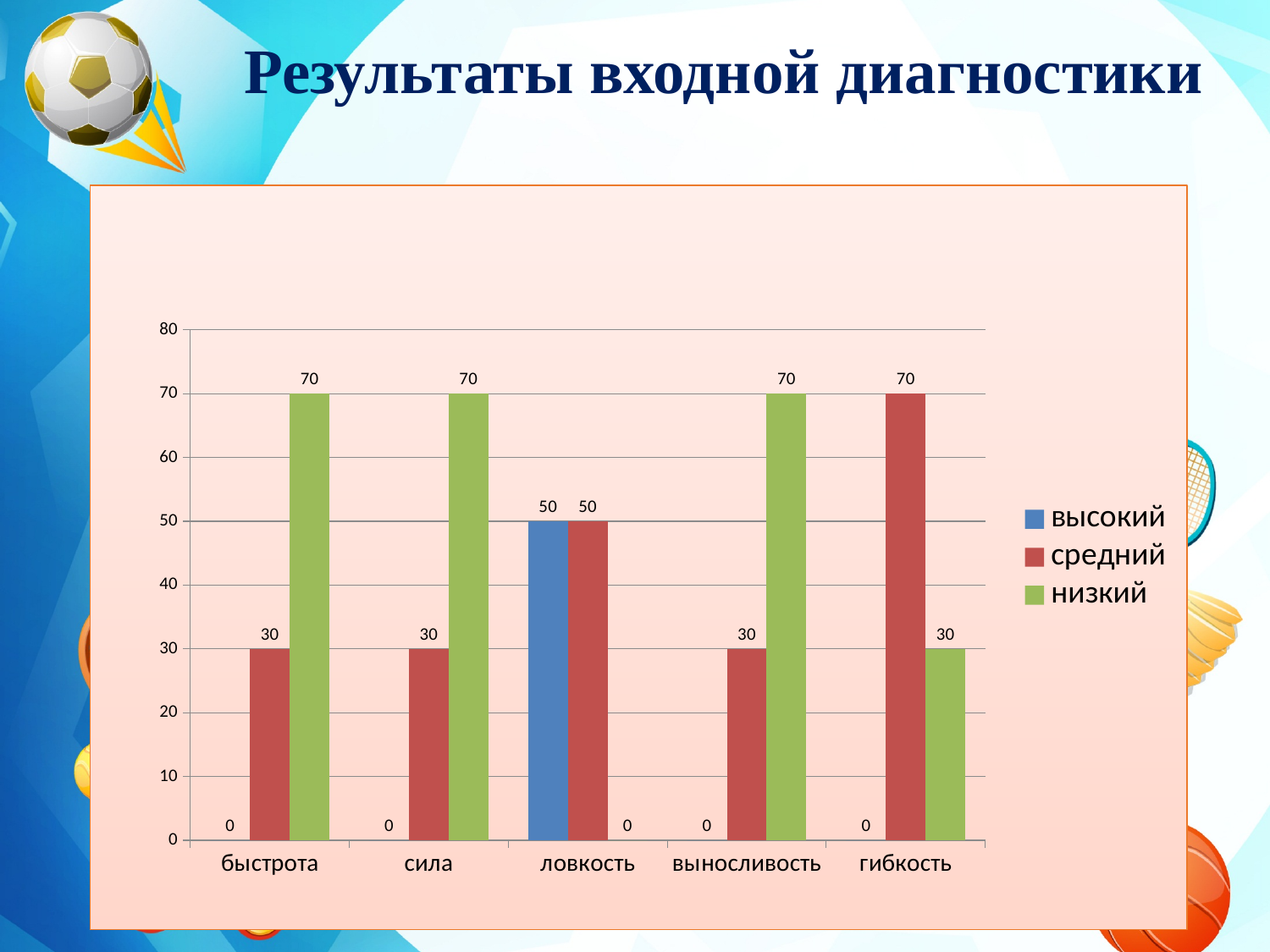
Which is larger for гибкость: средний or низкий? средний What is the value of средний for гибкость? 70 What is the difference between низкий and средний for сила? 40 What is the value of низкий for ловкость? 0 How many categories are shown on the x axis? 5 What type of chart is shown on the slide? bar chart How many series does the legend list? 3 What is the title of the slide? Результаты входной диагностики Which category has the highest value for высокий? ловкость What is the value of низкий for быстрота? 70 Which category has the lowest value for низкий? ловкость What is the value of высокий for ловкость? 50